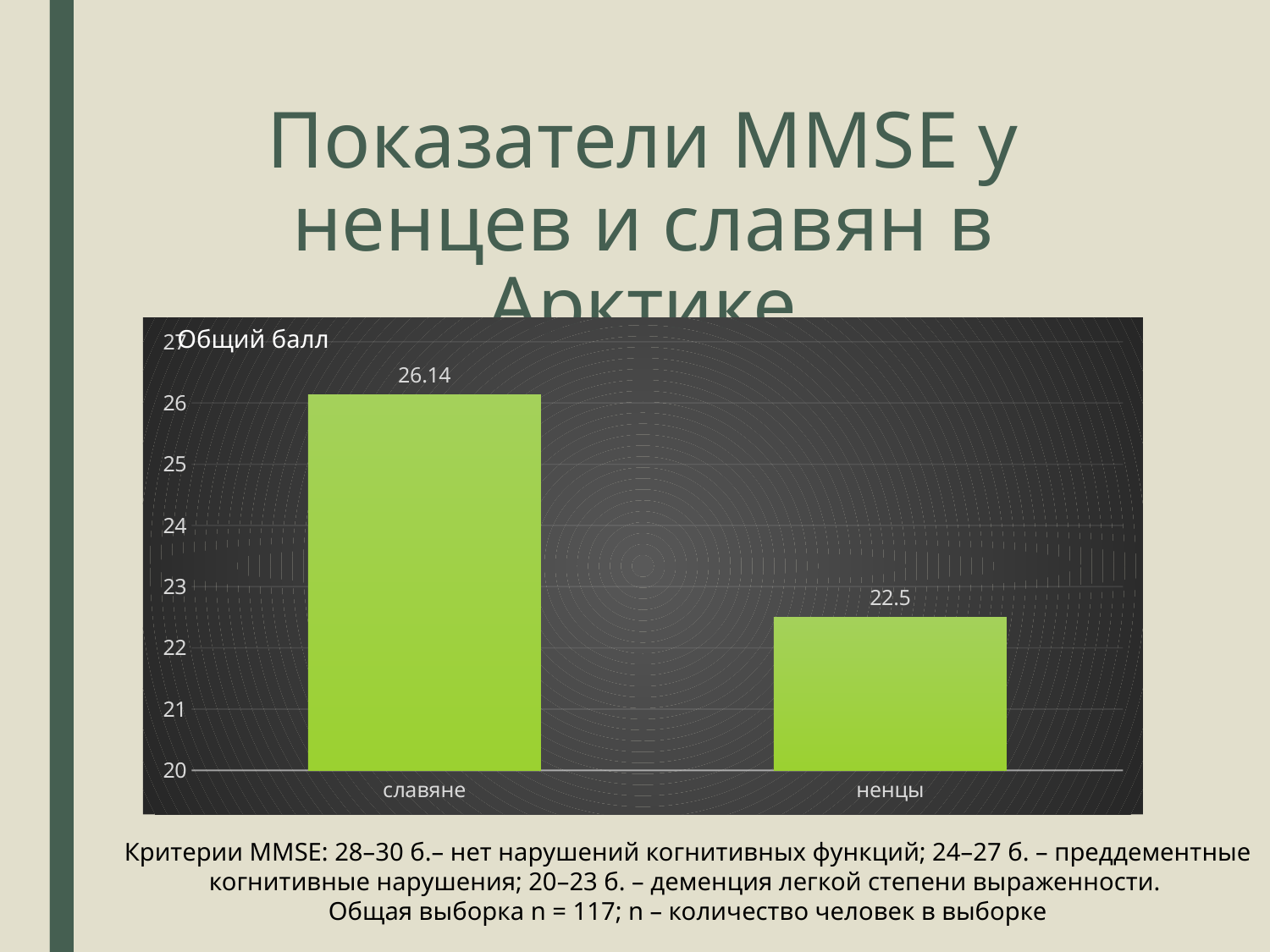
What is the value for ненцы? 22.5 What is the lowest value shown on the y axis? 20 Which category has the highest value? славяне What is the value for славяне? 26.14 What kind of chart is shown on the slide? bar chart Which category has the lowest value? ненцы Is the value for ненцы greater or less than 23? less How many categories are shown on the x axis? 2 What is the title of the chart? Общий балл Which is larger, the value for славяне or the value for ненцы? славяне What is the difference between the values for славяне and ненцы? 3.64 Is the value for славяне greater or less than 26? greater